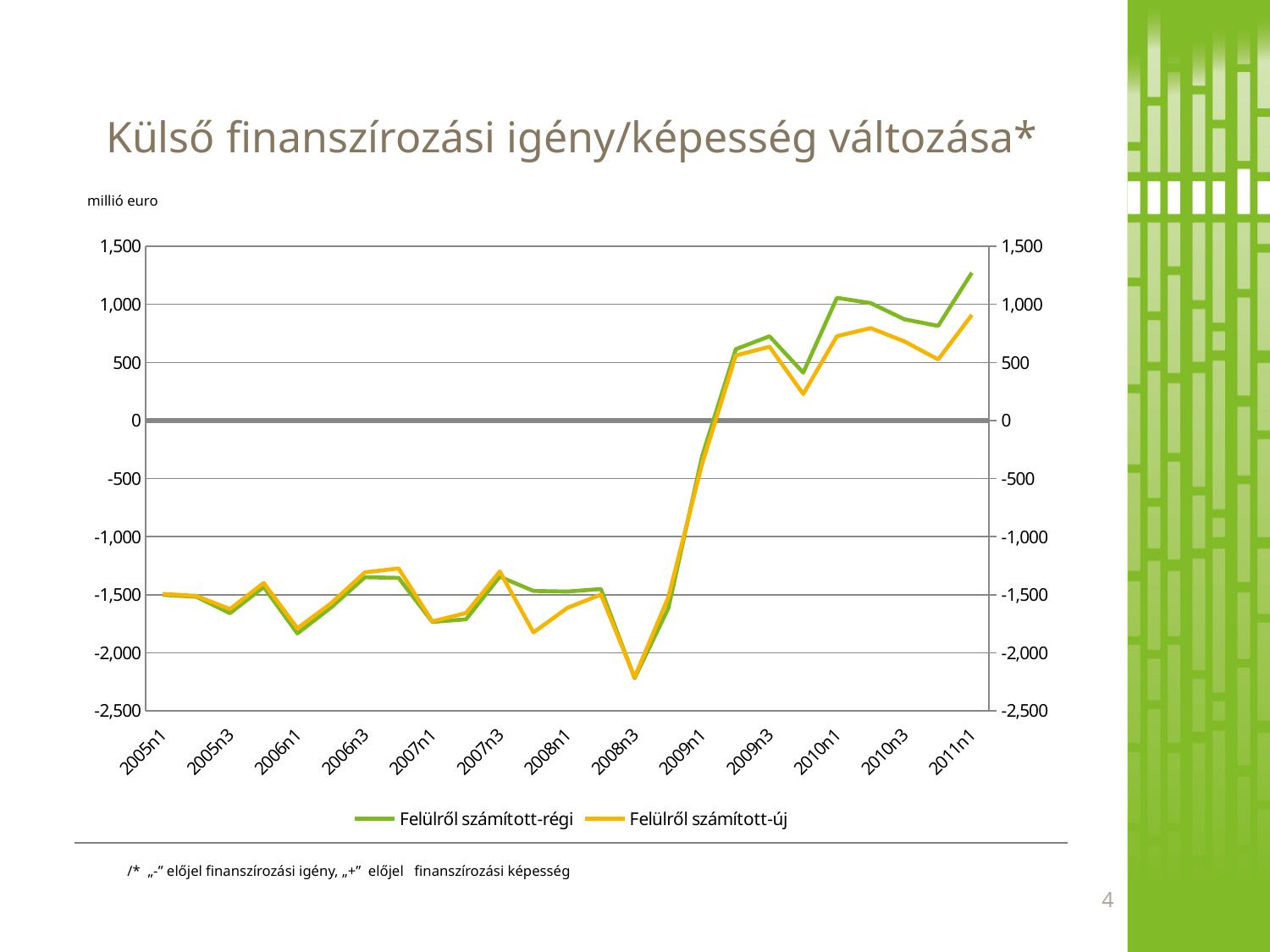
At 2011n1, which series has the higher value, Felülről számított-régi or Felülről számított-új? Felülről számított-régi Is the value of Felülről számított-régi at 2007n1 greater or less than -1,500? less How many series does the legend list? 2 Is the value of Felülről számított-régi at 2011n1 greater or less than 1,000? greater Is the value of Felülről számított-új at 2009n3 greater or less than 500? greater What are the two series named in the legend? Felülről számított-régi and Felülről számított-új Do the values of Felülről számított-új rise or fall between 2008n3 and 2009n3? rise What unit is indicated above the chart? millió euro At which x-axis label does the Felülről számított-régi series reach its lowest value? 2008n3 What kind of chart is shown on the slide? line chart